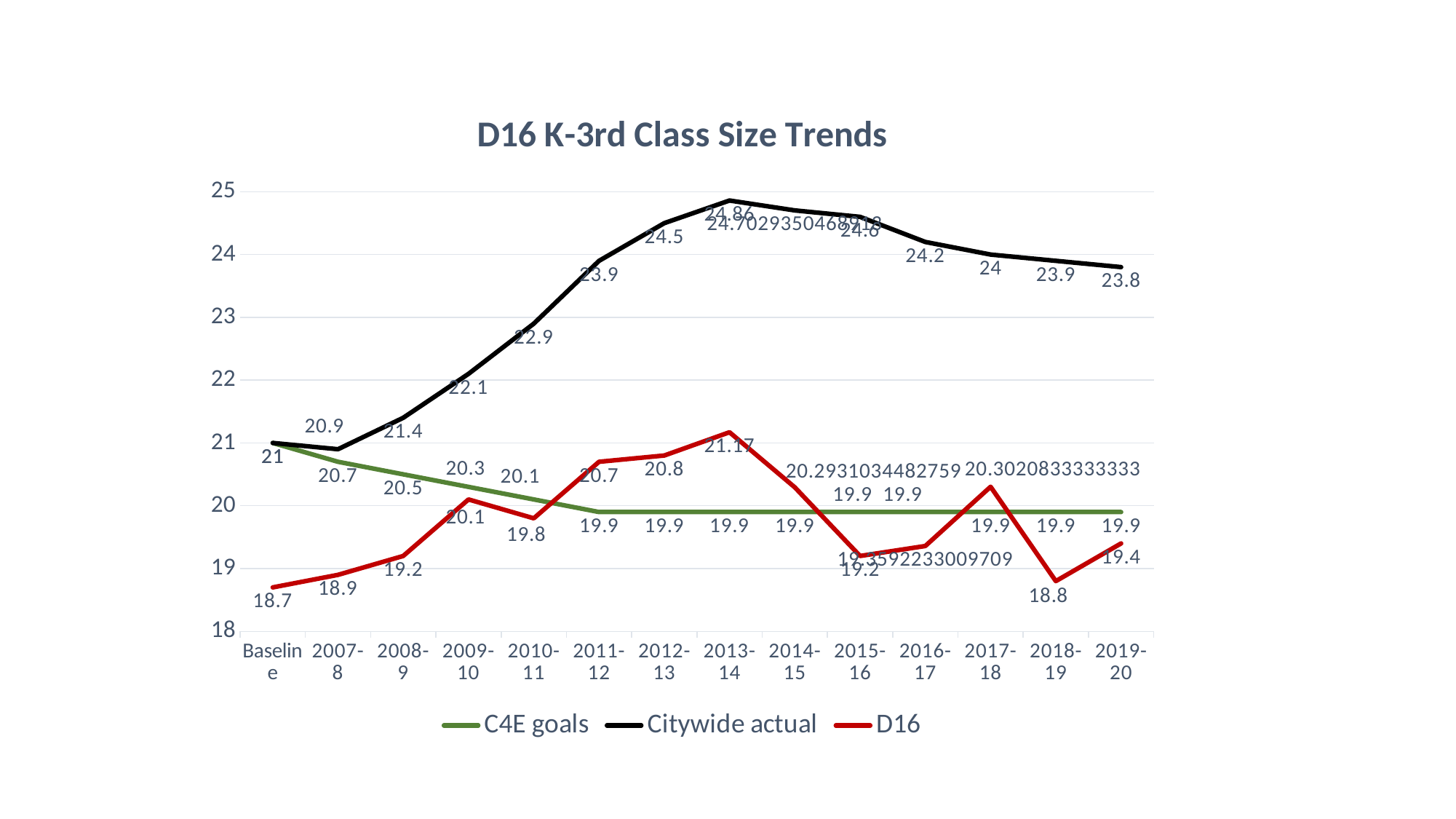
How many series does the legend list? 3 Is the Citywide actual value for 2014-15 greater or less than 24? greater In which year does the Citywide actual series reach its highest value? 2013-14 What is the D16 value at Baseline? 18.7 How many categories are shown on the x axis? 14 What is the Citywide actual value for 2019-20? 23.8 What is the C4E goals value for 2009-10? 20.3 What is the difference between the Citywide actual value in 2019-20 and at Baseline? 2.8 What is the D16 value for 2013-14? 21.17 What kind of chart is shown on the slide? line chart In 2011-12, which is larger: the D16 value or the C4E goals value? D16 In which year does the D16 series reach its highest value? 2013-14